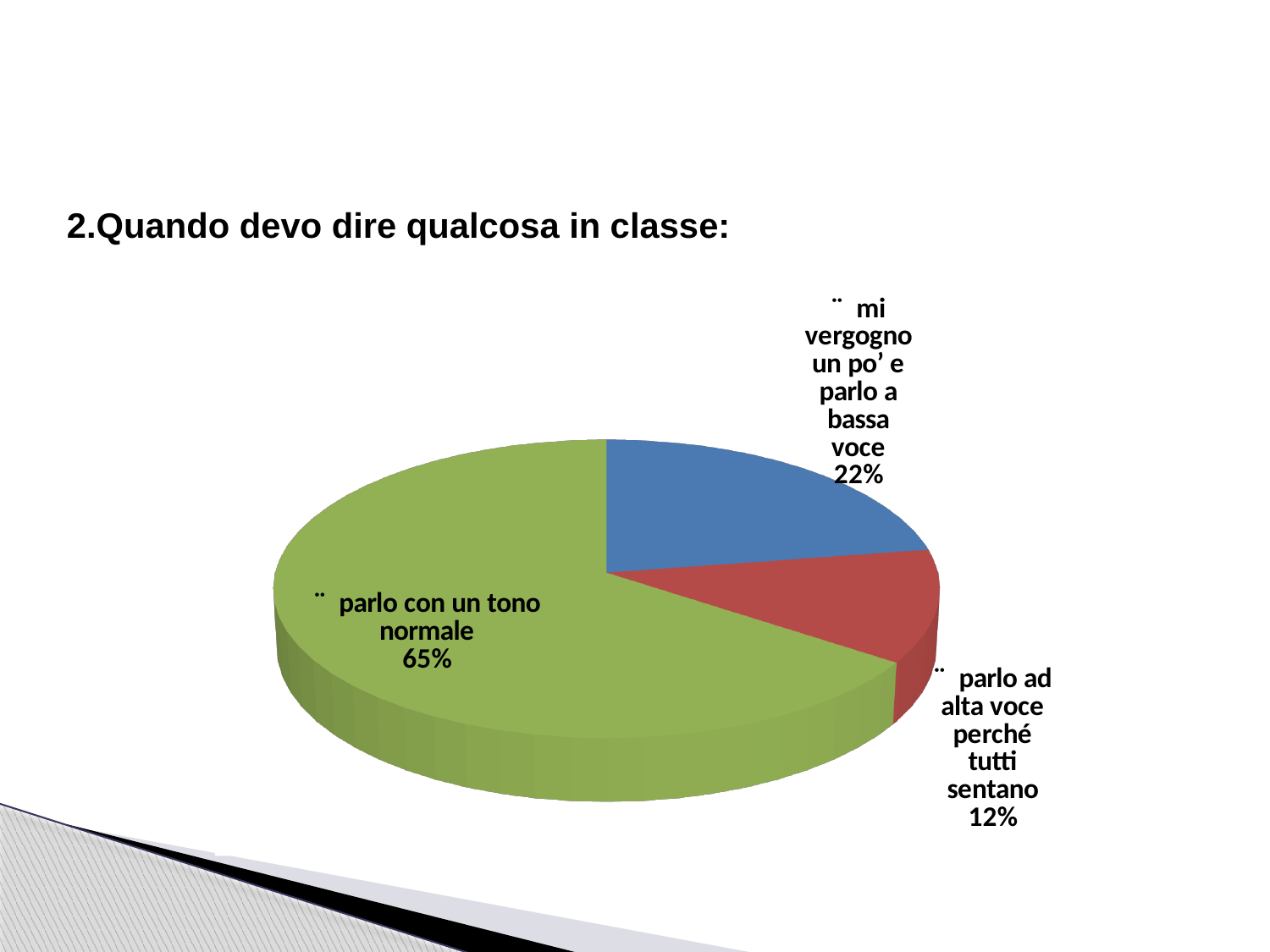
What is the title of the chart? 2.Quando devo dire qualcosa in classe: What percentage of the pie is 'parlo con un tono normale'? 65% What is the difference in percentage points between 'mi vergogno un po' e parlo a bassa voce' and 'parlo ad alta voce perché tutti sentano'? 10 What is the difference in percentage points between 'parlo con un tono normale' and 'mi vergogno un po' e parlo a bassa voce'? 43 Which slice of the pie is the smallest? parlo ad alta voce perché tutti sentano What percentage of the pie is 'parlo ad alta voce perché tutti sentano'? 12% What kind of chart is shown on the slide? pie chart Which slice of the pie is the largest? parlo con un tono normale What colour is the slice for 'parlo con un tono normale'? green Which is larger: the slice for 'mi vergogno un po' e parlo a bassa voce' or the slice for 'parlo ad alta voce perché tutti sentano'? mi vergogno un po' e parlo a bassa voce What percentage of the pie is 'mi vergogno un po' e parlo a bassa voce'? 22% How many slices does the pie chart have? 3